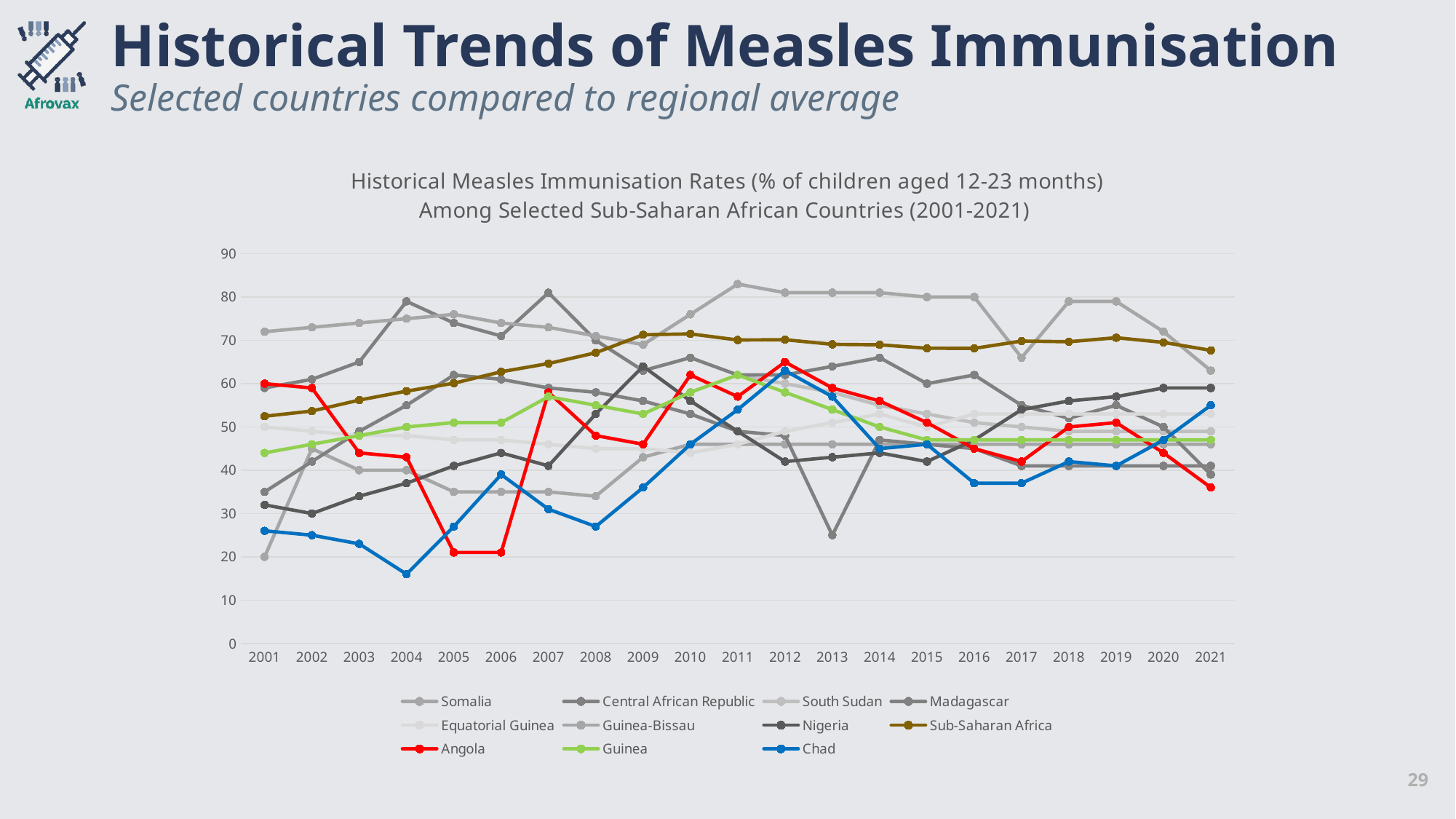
Is the value for Chad in 2004 greater or less than 20? less What colour is the Angola line in the chart? red How many years are plotted along the x axis? 21 How many series does the legend list? 11 What kind of chart is shown on the slide? line chart Is the value for Sub-Saharan Africa in 2021 greater or less than 60? greater In 2021, which is higher: Chad or Angola? Chad Is the value for Angola in 2005 greater or less than 30? less Does the Sub-Saharan Africa line rise or fall from 2001 to 2012? rise In 2004, which is higher: Angola or Chad? Angola